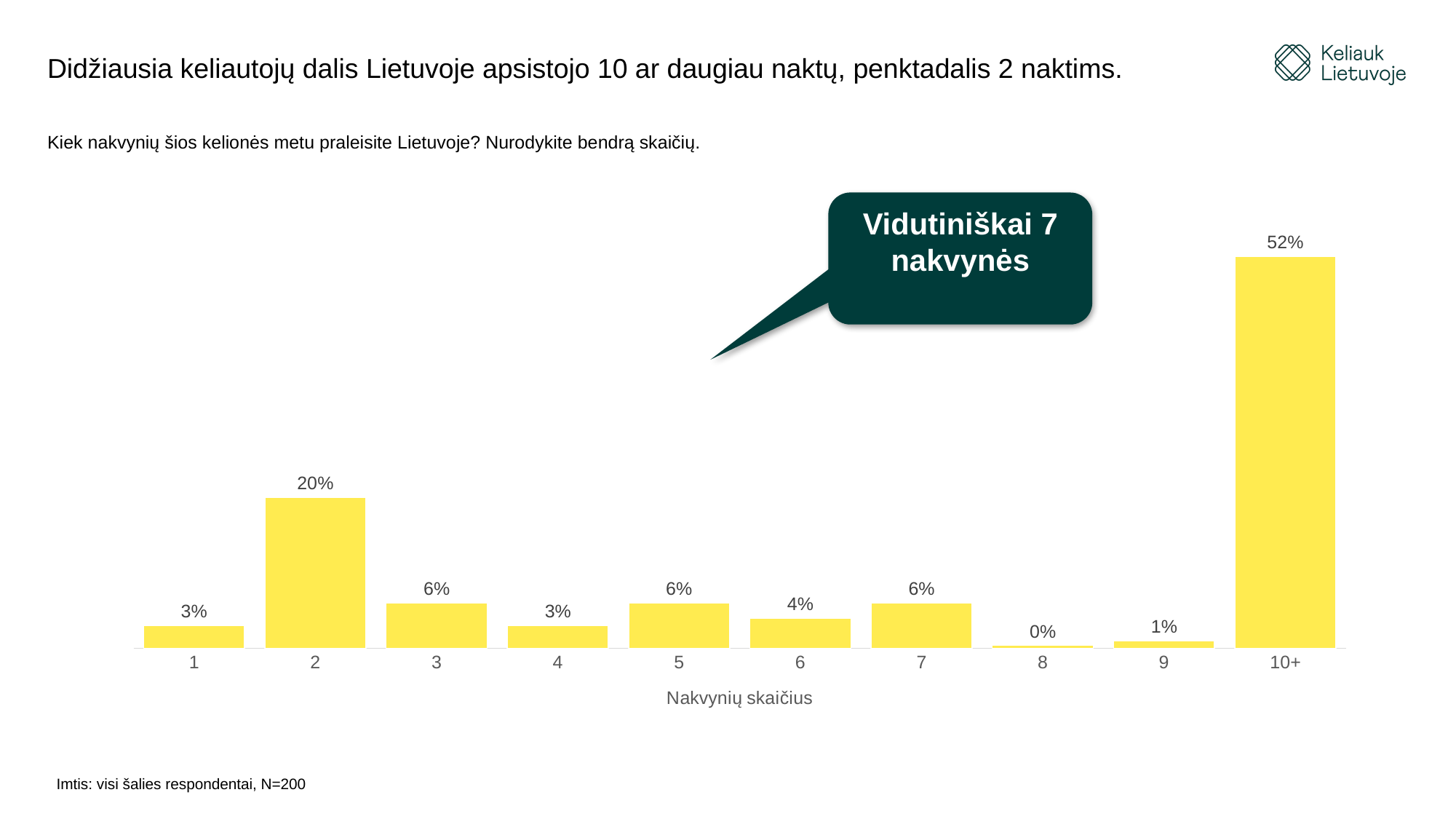
Which is larger: the share for 5 nights or the share for 6 nights? 5 nights What type of chart is shown on the slide? Bar chart What is the difference between the share for 10+ nights and the share for 2 nights? 32 percentage points Which number of nights has the highest share of respondents? 10+ How many categories are shown on the x axis of the chart? 10 Which number of nights has the lowest share of respondents? 8 What is the x-axis title of the chart? Nakvynių skaičius What is the value for 9 nights? 1% What is the value shown for the '10+' nights category? 52% What percentage of respondents stayed 6 nights? 4% What average number of nights does the callout on the chart state? 7 What percentage of respondents stayed 2 nights in Lithuania? 20%